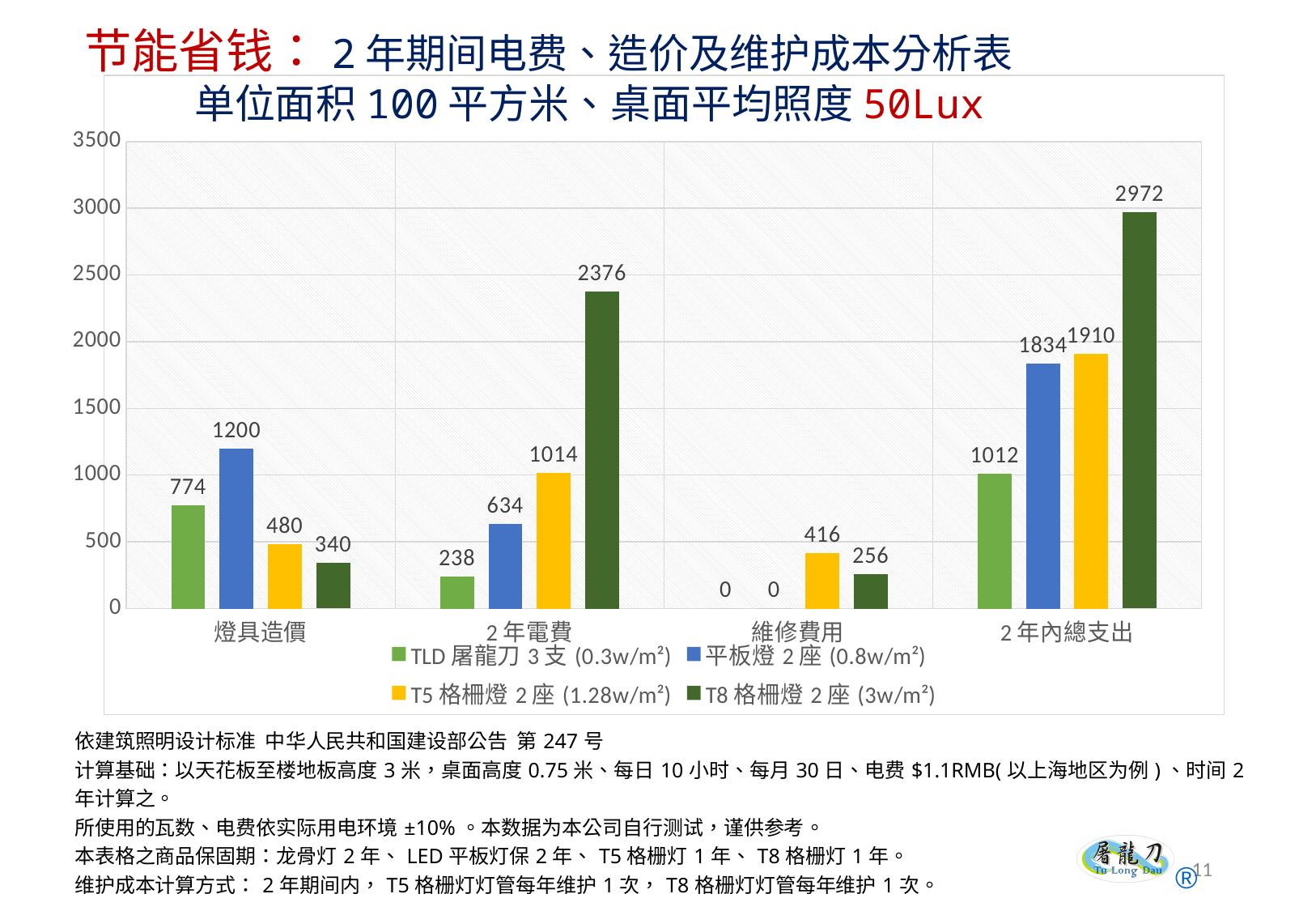
In the 2年電費 category, which is larger: the value for 平板燈 2座 (0.8w/m²) or the value for T5 格柵燈 2座 (1.28w/m²)? T5 格柵燈 2座 (1.28w/m²) Which series has the lowest value in the 燈具造價 category? T8 格柵燈 2座 (3w/m²) What is the difference between the 2年內總支出 values for T8 格柵燈 2座 (3w/m²) and TLD 屠龍刀 3支 (0.3w/m²)? 1960 Which series has the highest value in the 2年內總支出 category? T8 格柵燈 2座 (3w/m²) What is the value for TLD 屠龍刀 3支 (0.3w/m²) in the 燈具造價 category? 774 Is the value for 平板燈 2座 (0.8w/m²) in the 2年內總支出 category greater or less than 1500? greater What kind of chart is shown on the slide? bar chart How many series does the legend list? 4 What is the value for T5 格柵燈 2座 (1.28w/m²) in the 維修費用 category? 416 What is the value for T8 格柵燈 2座 (3w/m²) in the 2年電費 category? 2376 How many categories are shown on the x axis of the chart? 4 What is the value for 平板燈 2座 (0.8w/m²) in the 維修費用 category? 0